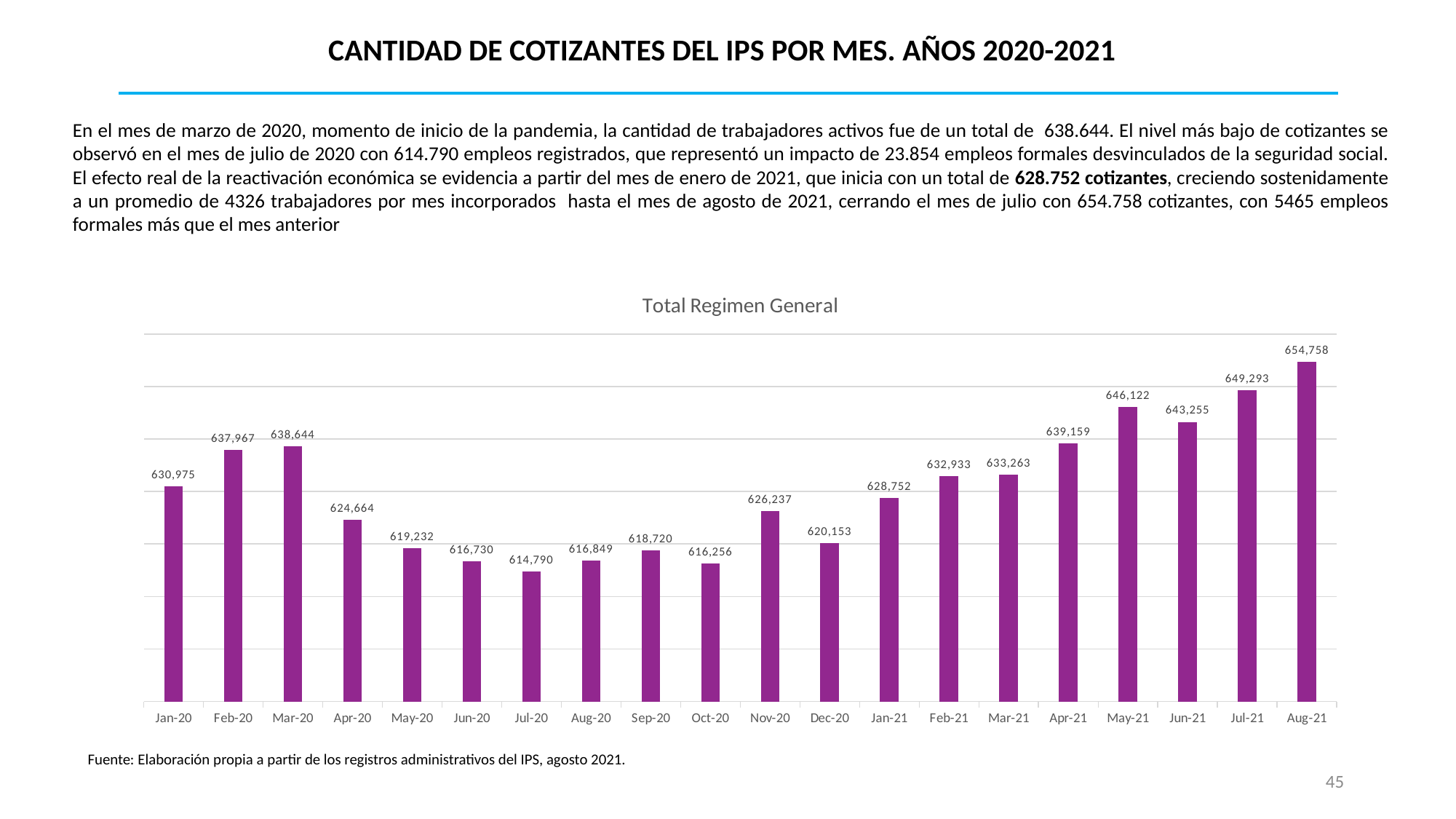
What is the value for Jan-21? 628,752 Do the values rise or fall from Jan-21 to Aug-21? Rise What is the value for Mar-20? 638,644 Which month has the highest value? Aug-21 Which month has the lowest value? Jul-20 How many months are plotted in the chart? 20 Which is larger, the value for Apr-20 or the value for Dec-20? Apr-20 What is the difference between the values for Aug-21 and Jul-21? 5,465 What type of chart is shown on the slide? Bar chart What is the value for Nov-20? 626,237 What is the difference between the values for Mar-20 and Jul-20? 23,854 What is the title of the chart? Total Regimen General